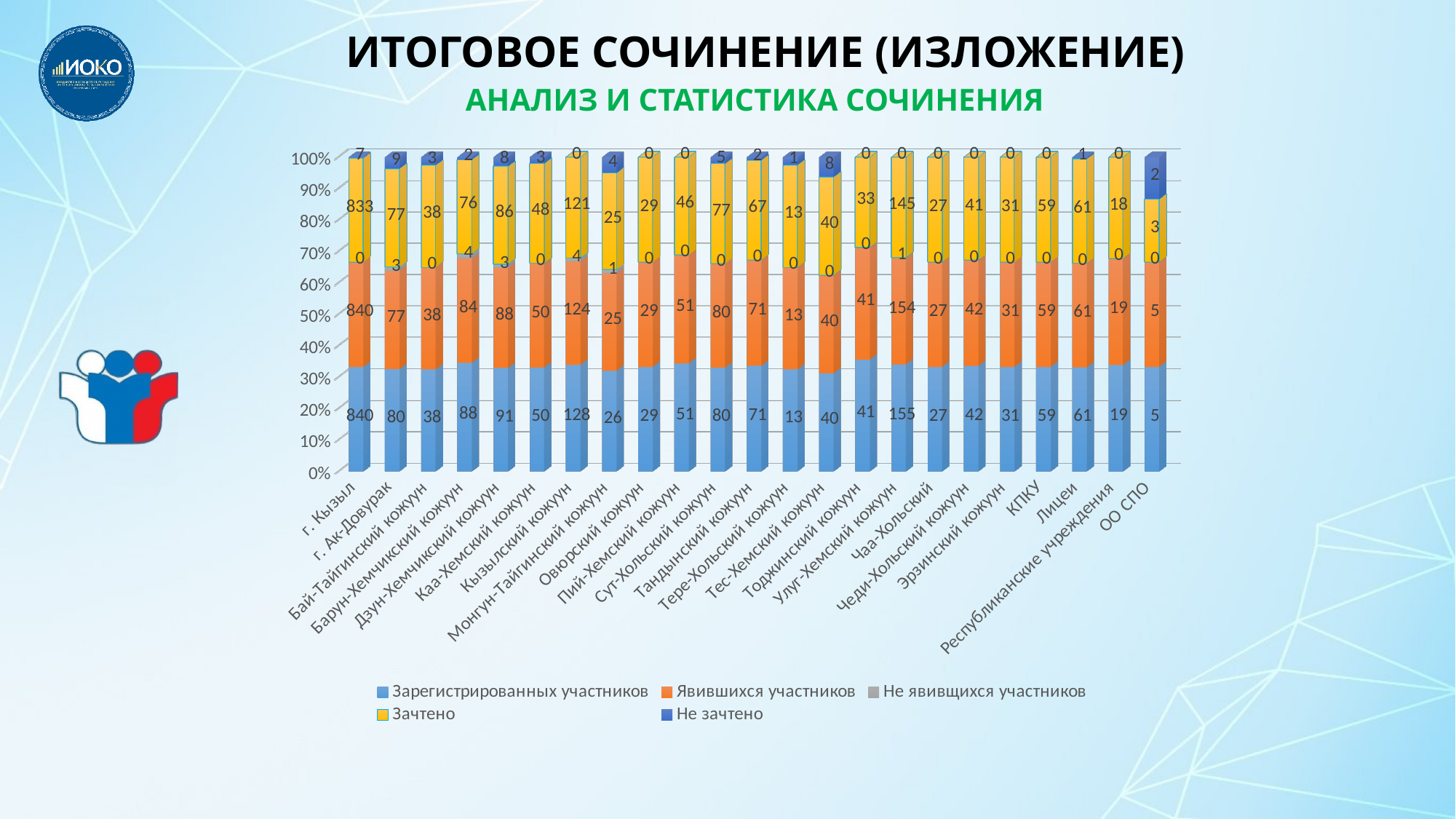
What is the value of Зачтено for Улуг-Хемский кожуун? 145 What kind of chart is shown on the slide? stacked bar chart Which category has the highest value of Зарегистрированных участников? г. Кызыл What is the value of Не зачтено for Тес-Хемский кожуун? 8 How many series does the legend list? 5 What is the difference between Зарегистрированных участников and Явившихся участников for Барун-Хемчикский кожуун? 4 How many categories are shown along the x axis? 23 What is the value of Явившихся участников for Кызылский кожуун? 124 Which series is shown in yellow in the legend? Зачтено Which has a larger value of Зачтено: Дзун-Хемчикский кожуун or Сут-Хольский кожуун? Дзун-Хемчикский кожуун What is the value of Зарегистрированных участников for г. Кызыл? 840 Which category has the lowest value of Зарегистрированных участников? ОО СПО